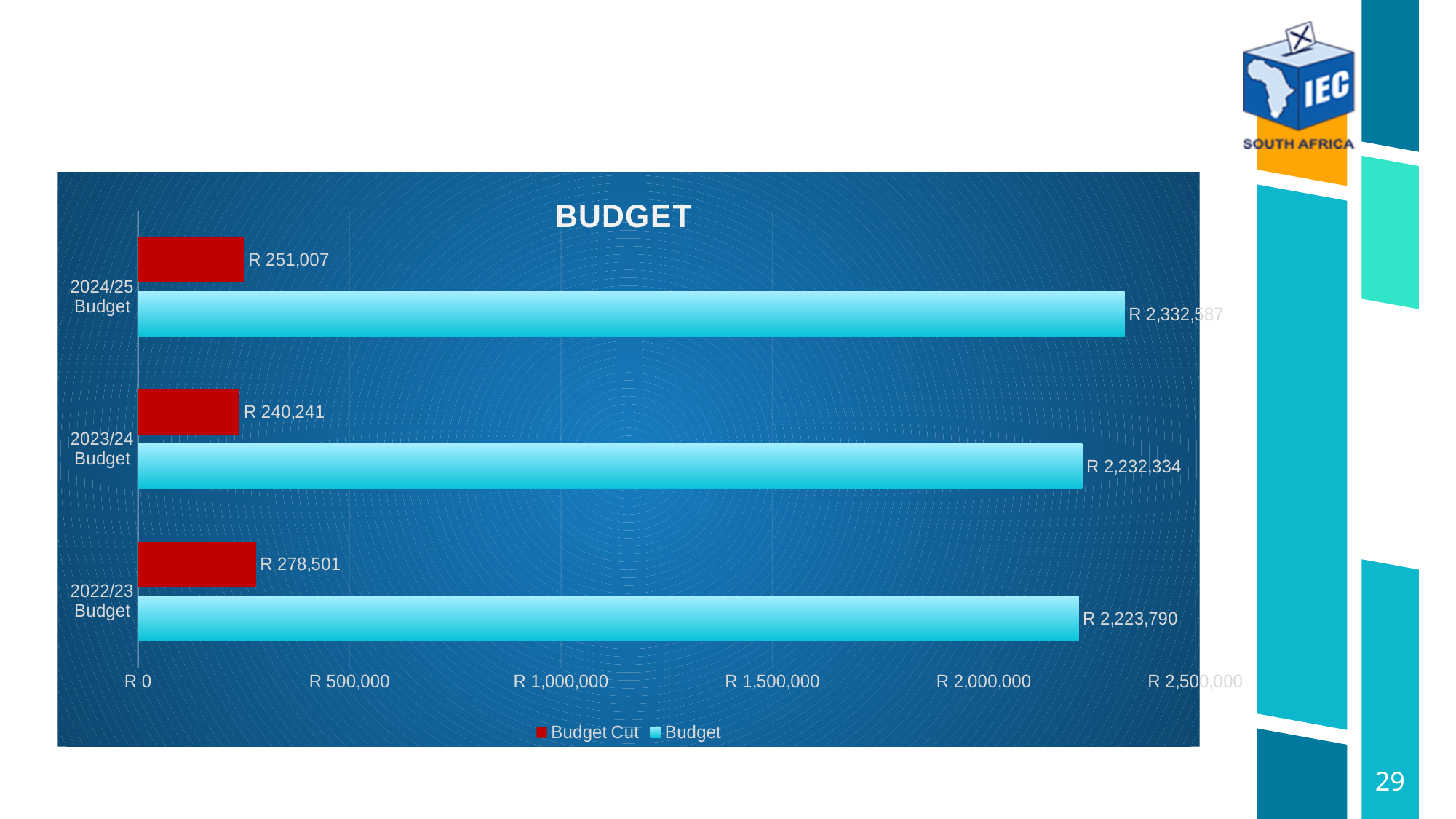
What is the title of the chart? BUDGET What is the Budget value for 2024/25 Budget? R 2,332,587 Which budget year has the lowest Budget Cut? 2023/24 Budget What type of chart is shown on the slide? Bar chart How many budget years are shown on the chart? 3 How many series does the legend list? 2 What is the difference between the Budget Cut for 2022/23 Budget and 2023/24 Budget? R 38,260 Which budget year has the highest Budget Cut? 2022/23 Budget What is the Budget value for 2022/23 Budget? R 2,223,790 Is the Budget value for 2024/25 Budget greater or less than R 2,000,000? greater Which is larger, the Budget for 2023/24 Budget or the Budget for 2022/23 Budget? 2023/24 Budget What is the Budget Cut value for 2023/24 Budget? R 240,241